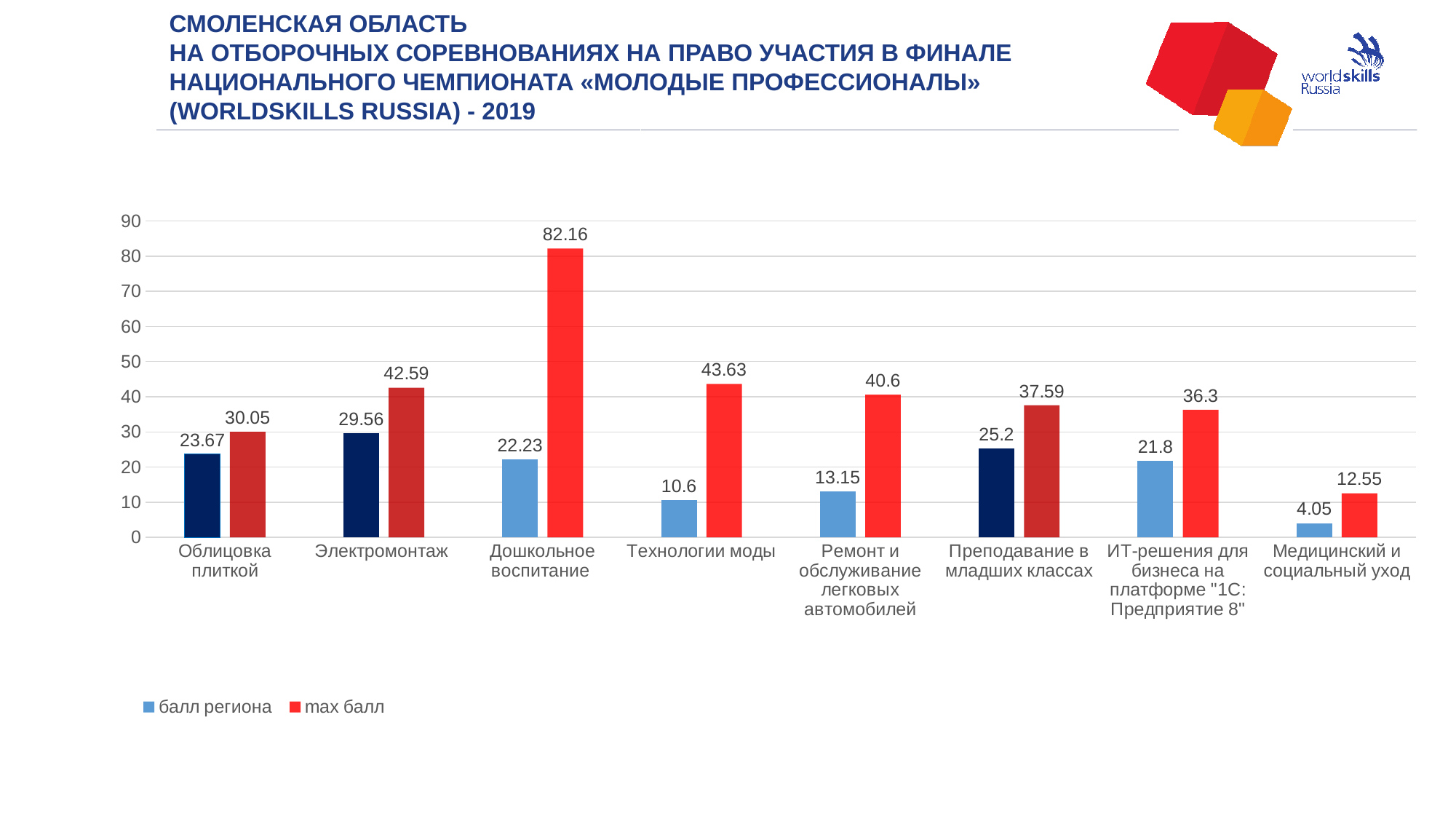
Which category has the highest 'балл региона' value? Электромонтаж What is the difference between 'max балл' and 'балл региона' for Медицинский и социальный уход? 8.5 How many series does the legend list? 2 Which category has the highest 'max балл' value? Дошкольное воспитание What is the 'max балл' value for Дошкольное воспитание? 82.16 What is the difference between 'max балл' and 'балл региона' for Дошкольное воспитание? 59.93 What kind of chart is shown on the slide? Bar chart Which is larger: the 'балл региона' for Облицовка плиткой or for ИТ-решения для бизнеса на платформе "1С: Предприятие 8"? Облицовка плиткой What is the 'балл региона' value for Преподавание в младших классах? 25.2 How many categories are shown on the x axis? 8 What is the 'балл региона' value for Технологии моды? 10.6 Which category has the lowest 'балл региона' value? Медицинский и социальный уход